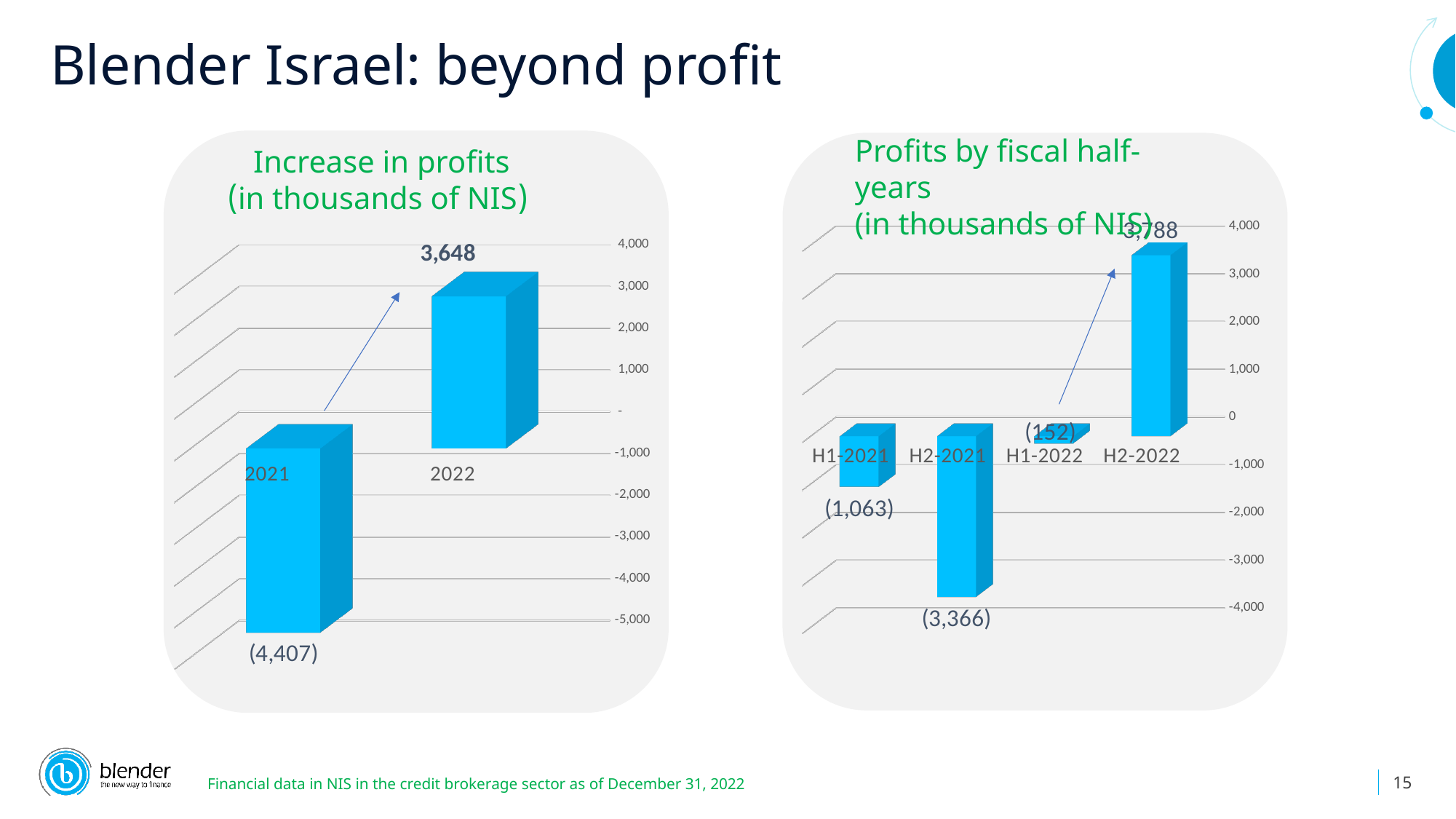
In the 'Increase in profits' chart, what is the value for 2021? (4,407) In the 'Profits by fiscal half-years' chart, how many half-years are shown? 4 In the 'Increase in profits' chart, what is the value for 2022? 3,648 In the 'Profits by fiscal half-years' chart, which half-year has the highest profit? H2-2022 In the 'Profits by fiscal half-years' chart, what is the value for H2-2022? 3,788 In the 'Profits by fiscal half-years' chart, which half-year has the lowest profit? H2-2021 In the 'Increase in profits' chart, how many categories are shown? 2 In the 'Profits by fiscal half-years' chart, which is larger, the value for H1-2021 or the value for H1-2022? H1-2022 What kind of chart is the 'Increase in profits' chart? Bar chart In the 'Increase in profits' chart, do the values rise or fall from 2021 to 2022? Rise In the 'Profits by fiscal half-years' chart, what is the value for H1-2022? (152) In the 'Profits by fiscal half-years' chart, what is the value for H2-2021? (3,366)